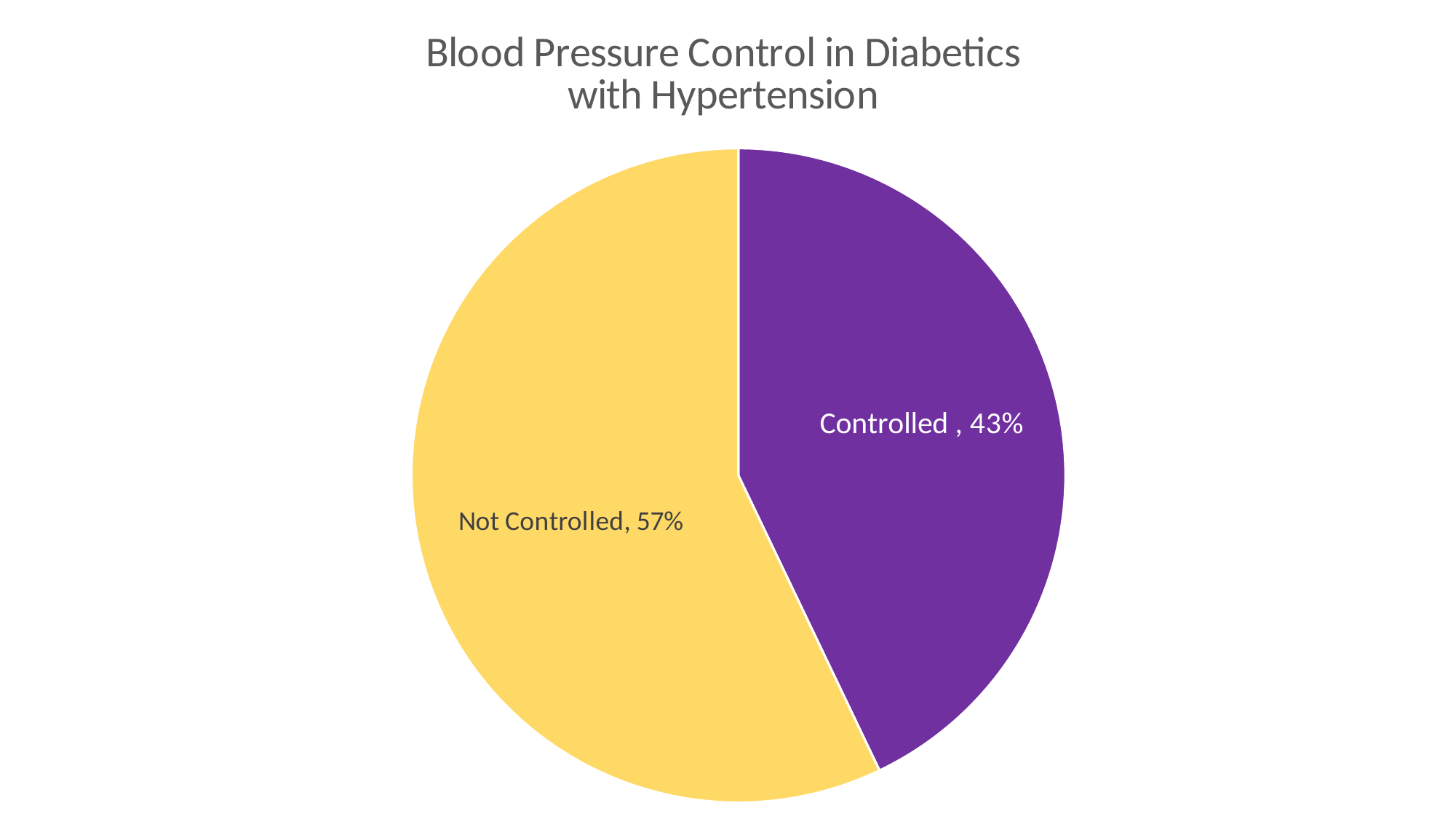
Which slice is the largest in the pie chart? Not Controlled What is the difference in percentage points between the Not Controlled and Controlled slices? 14 What colour is the Not Controlled slice? Yellow Which is larger, the Controlled slice or the Not Controlled slice? Not Controlled What is the title of the chart? Blood Pressure Control in Diabetics with Hypertension What percentage of diabetics with hypertension have controlled blood pressure? 43% What share of the pie does the Controlled slice represent? 43% How many slices does the pie chart have? 2 Which slice is the smallest in the pie chart? Controlled What type of chart is shown on the slide? Pie chart What percentage of diabetics with hypertension have blood pressure that is not controlled? 57%